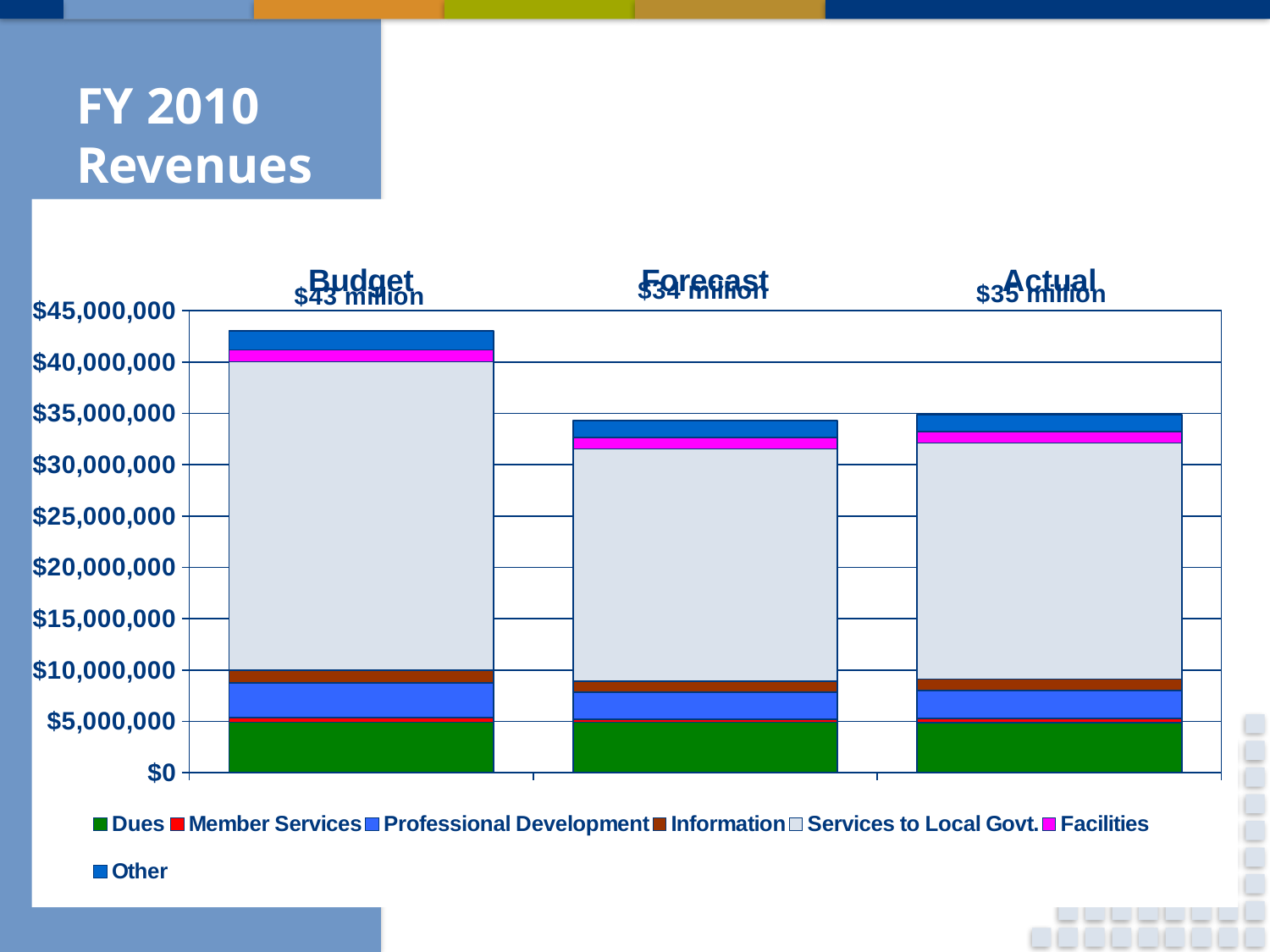
Is the total for the Forecast bar greater or less than $40,000,000? less What kind of chart is shown on the slide? Stacked bar chart What is the difference between the Budget total and the Forecast total? $9 million What is the title of the slide containing the chart? FY 2010 Revenues Which category has the lowest total revenue? Forecast How many bars (categories) are shown in the chart? 3 What is the total revenue shown for the Budget bar? $43 million How many series does the legend list? 7 What is the total revenue shown for the Actual bar? $35 million Is the total for the Actual bar greater or less than $30,000,000? greater What is the total revenue shown for the Forecast bar? $34 million Which category has the highest total revenue? Budget